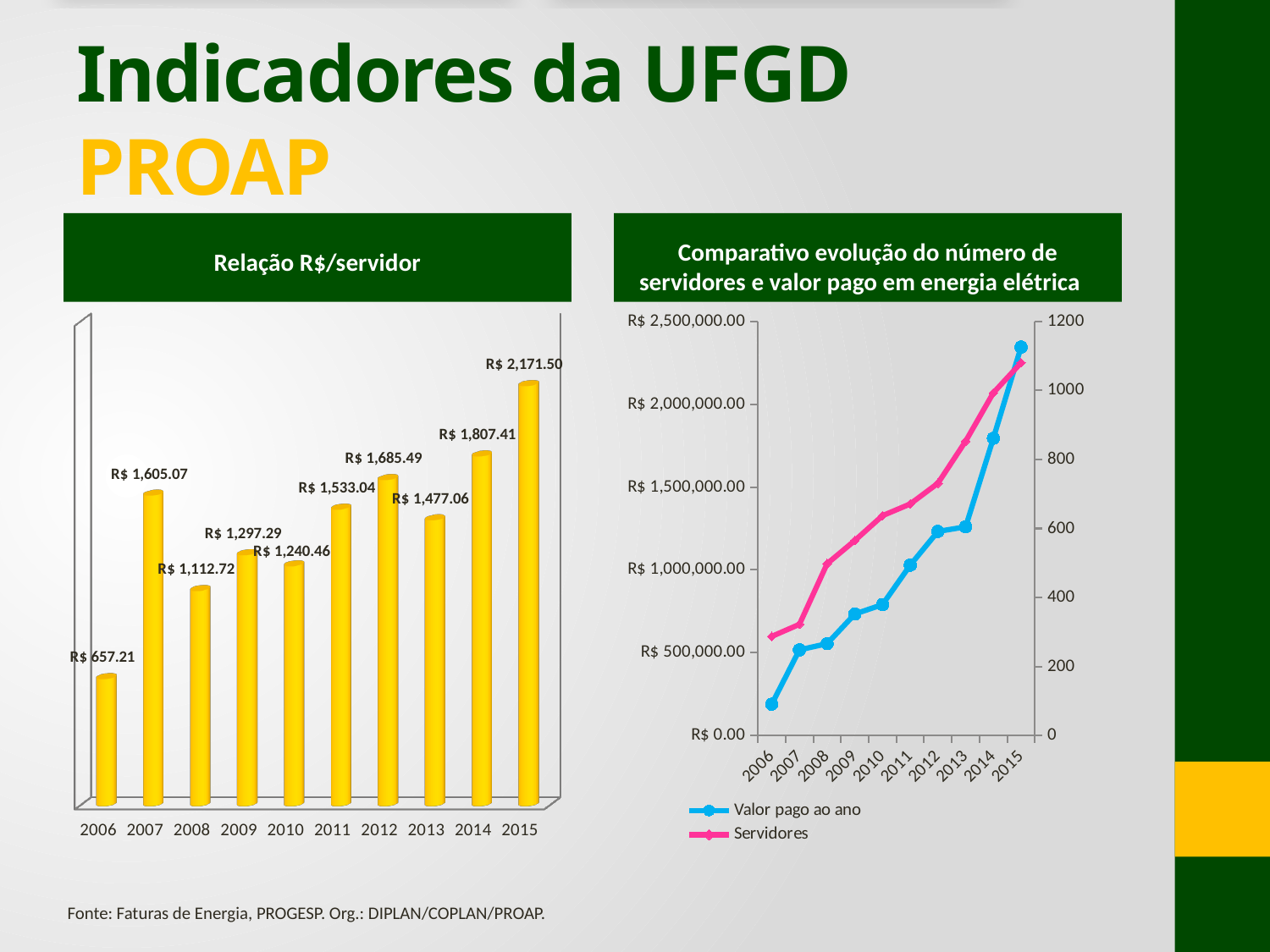
In the 'Relação R$/servidor' chart, which year has the lowest value? 2006 In the 'Relação R$/servidor' chart, which year has the highest value? 2015 In the 'Relação R$/servidor' chart, how many years are shown? 10 In the 'Relação R$/servidor' chart, what is the value for 2015? R$ 2,171.50 In the 'Relação R$/servidor' chart, what is the value for 2010? R$ 1,240.46 In the 'Relação R$/servidor' chart, which is larger, the value for 2007 or the value for 2011? 2007 What type of chart is the 'Relação R$/servidor' chart? Bar chart In the 'Comparativo evolução do número de servidores e valor pago em energia elétrica' chart, do the 'Servidores' values generally rise or fall from 2006 to 2015? rise In the 'Relação R$/servidor' chart, what is the value for 2006? R$ 657.21 In the 'Comparativo evolução do número de servidores e valor pago em energia elétrica' chart, how many series does the legend list? 2 In the 'Relação R$/servidor' chart, what is the difference between the 2015 value and the 2014 value? R$ 364.09 In the 'Comparativo evolução do número de servidores e valor pago em energia elétrica' chart, is the value of 'Valor pago ao ano' for 2006 greater or less than R$ 500,000.00? less